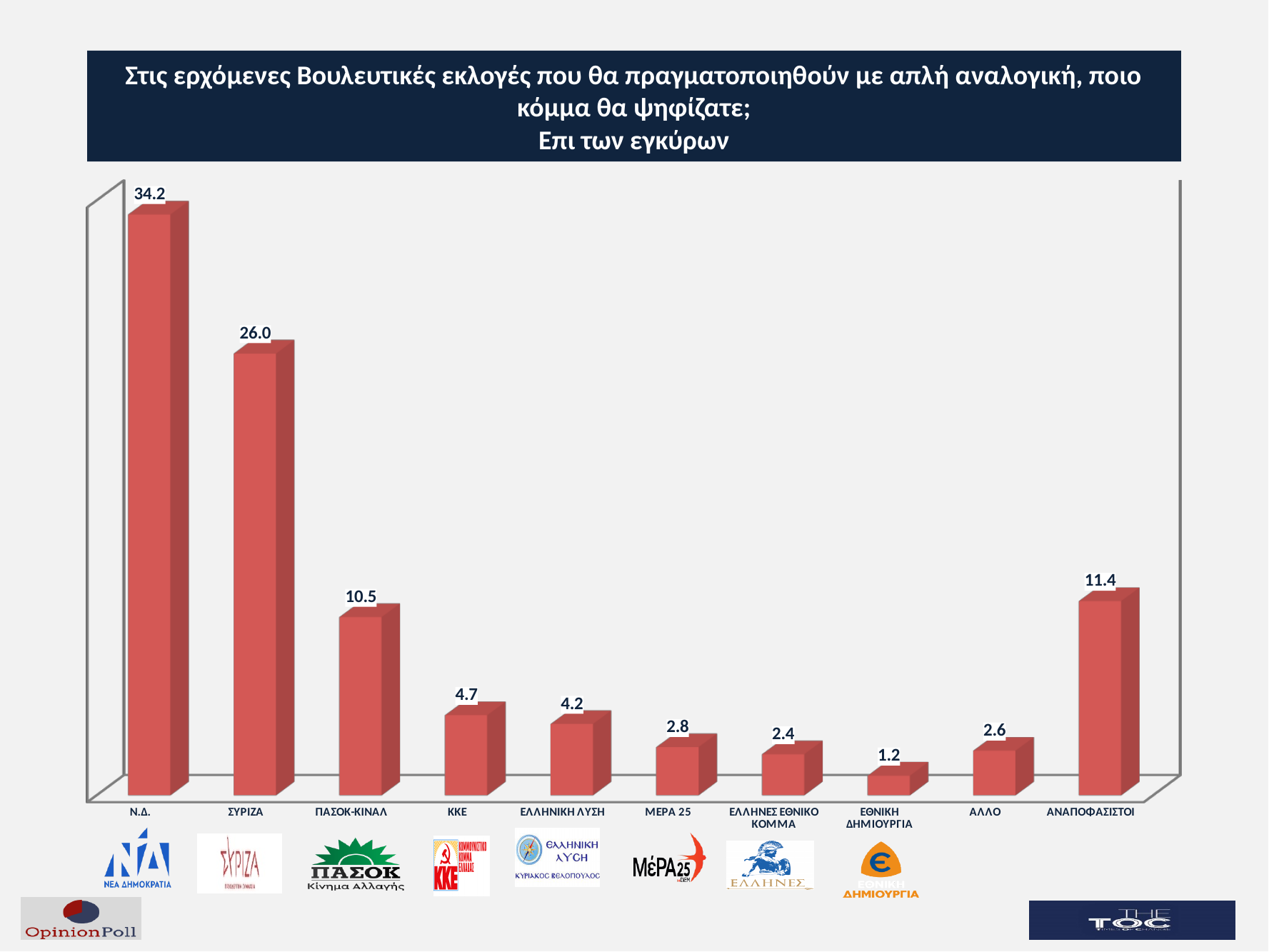
What is the difference between the values for Ν.Δ. and ΣΥΡΙΖΑ? 8.2 What value is shown for ΕΘΝΙΚΗ ΔΗΜΙΟΥΡΓΙΑ? 1.2 Which is larger, the value for ΜΕΡΑ 25 or the value for ΑΛΛΟ? ΜΕΡΑ 25 Which category has the highest value? Ν.Δ. What value is shown for ΣΥΡΙΖΑ? 26.0 What value is shown for ΚΚΕ? 4.7 What kind of chart is shown on the slide? Bar chart How many categories are shown on the chart? 10 Which category has the lowest value? ΕΘΝΙΚΗ ΔΗΜΙΟΥΡΓΙΑ What value is shown for ΑΝΑΠΟΦΑΣΙΣΤΟΙ? 11.4 What value is shown for Ν.Δ.? 34.2 What is the difference between the values for ΑΝΑΠΟΦΑΣΙΣΤΟΙ and ΠΑΣΟΚ-ΚΙΝΑΛ? 0.9